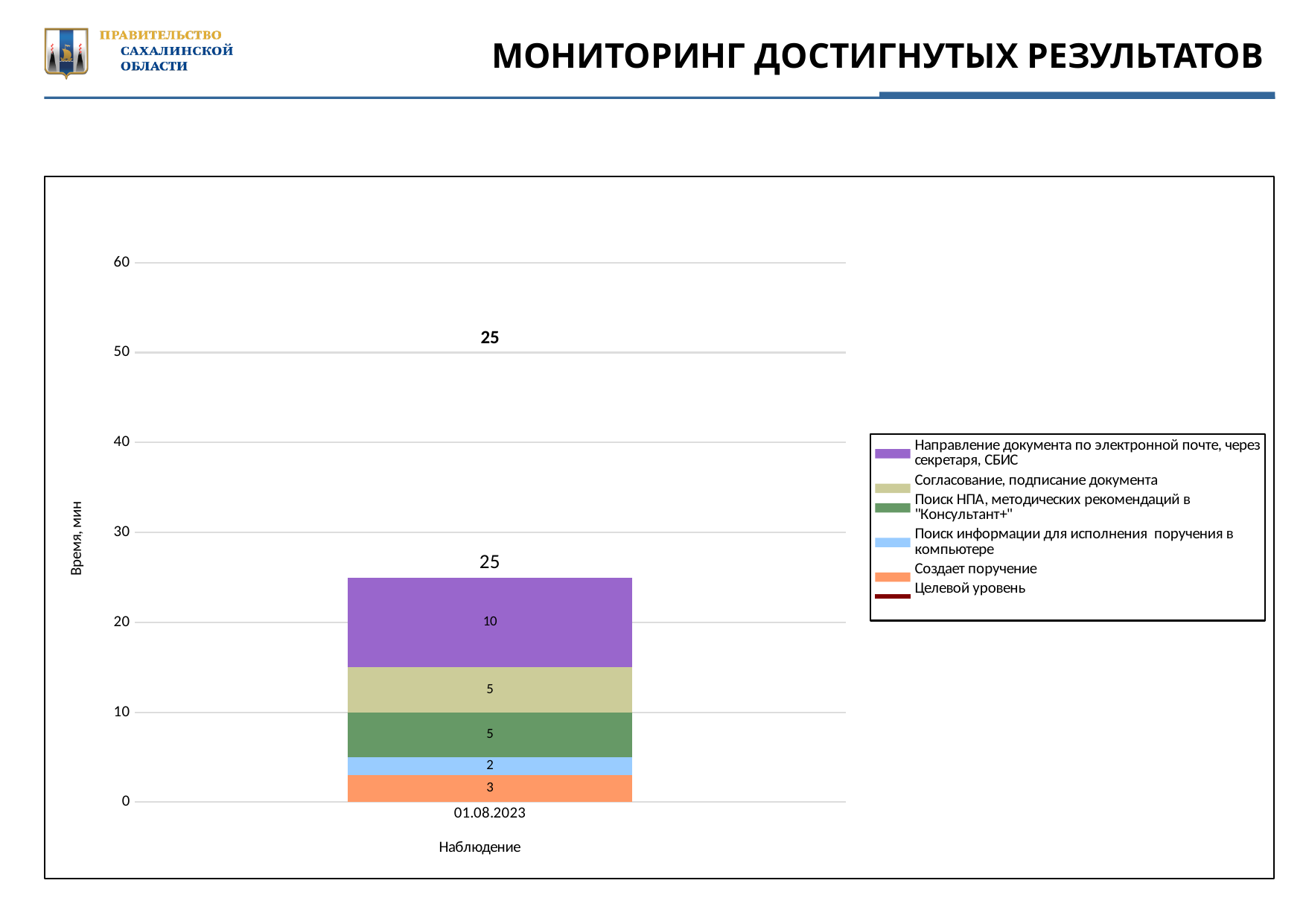
What is the value of the 'Поиск НПА, методических рекомендаций в "Консультант+"' segment for 01.08.2023? 5 What type of chart is shown on the slide? stacked bar chart What is the label of the vertical axis of the chart? Время, мин Which segment of the 01.08.2023 bar has the smallest value? Поиск информации для исполнения поручения в компьютере Which segment of the 01.08.2023 bar has the largest value? Направление документа по электронной почте, через секретаря, СБИС What is the total of the stacked bar for 01.08.2023? 25 What is the value of the 'Направление документа по электронной почте, через секретаря, СБИС' segment for 01.08.2023? 10 How many entries does the chart legend list? 6 What is the difference between the 'Направление документа по электронной почте, через секретаря, СБИС' segment and the 'Создает поручение' segment for 01.08.2023? 7 What is the value of the 'Поиск информации для исполнения поручения в компьютере' segment for 01.08.2023? 2 What is the value of the 'Создает поручение' segment for 01.08.2023? 3 What is the value of the 'Согласование, подписание документа' segment for 01.08.2023? 5